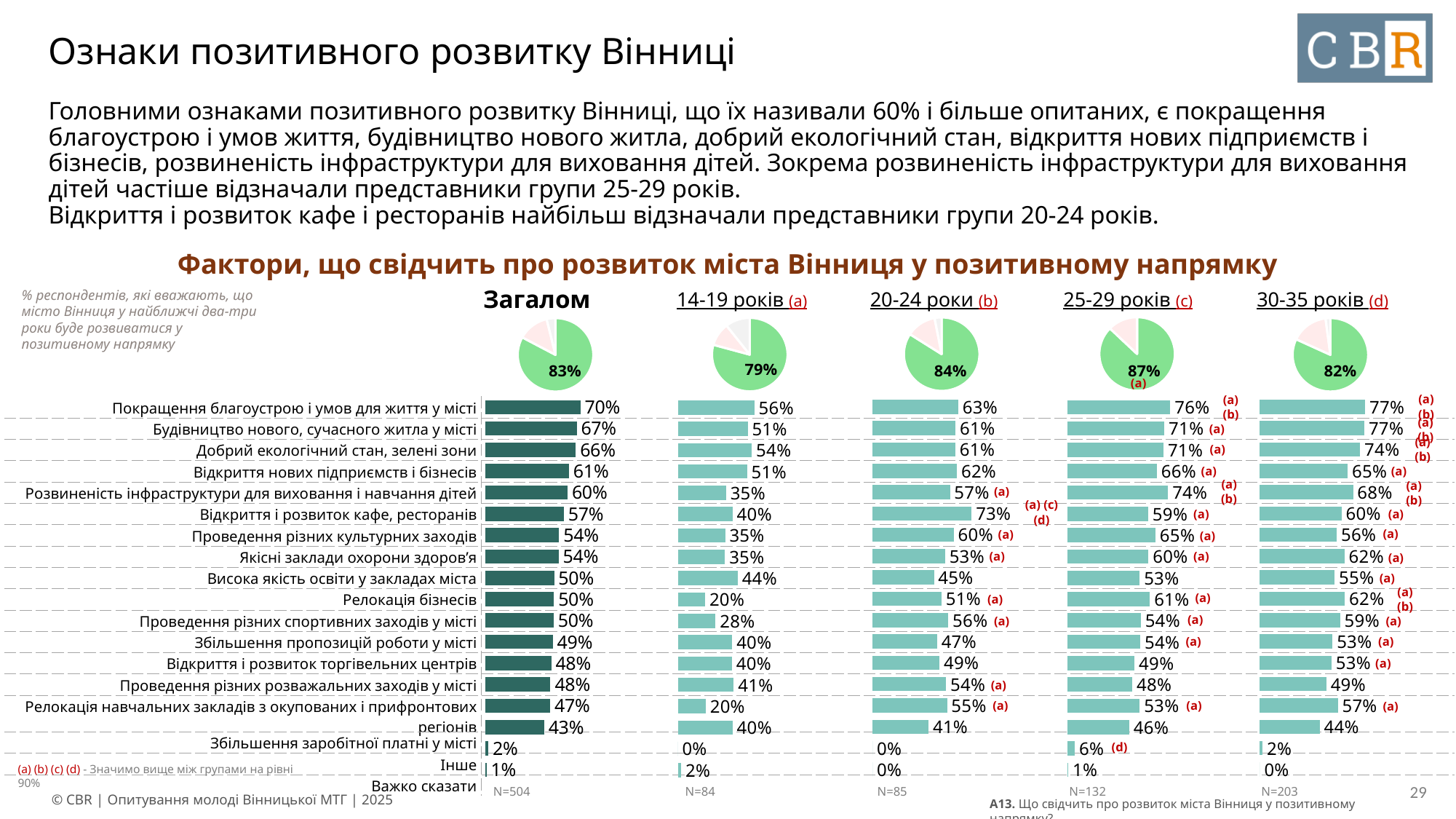
For 'Добрий екологічний стан, зелені зони', which group has the larger value: '25-29 років' or '30-35 років'? 30-35 років What type of chart is used to show the factors for each age group? Bar chart How many pie charts are shown on the slide? 5 In the 'Загалом' pie chart, what share of respondents believe Vinnytsia will develop in a positive direction? 83% In the 'Загалом' bar chart, what is the difference between 'Покращення благоустрою і умов для життя у місті' and 'Будівництво нового, сучасного житла у місті'? 3 percentage points In the 'Загалом' bar chart, which factor has the highest value? Покращення благоустрою і умов для життя у місті In the '30-35 років' bar chart, what is the value for 'Збільшення заробітної платні у місті'? 44% In the '20-24 роки' bar chart, what is the value for 'Відкриття і розвиток кафе, ресторанів'? 73% Which age group's pie chart shows the lowest percentage? 14-19 років (79%) In the 'Загалом' bar chart, what is the value for 'Покращення благоустрою і умов для життя у місті'? 70% In the '14-19 років' bar chart, what is the value for 'Релокація бізнесів'? 20% In the '25-29 років' pie chart, what percentage is shown? 87%